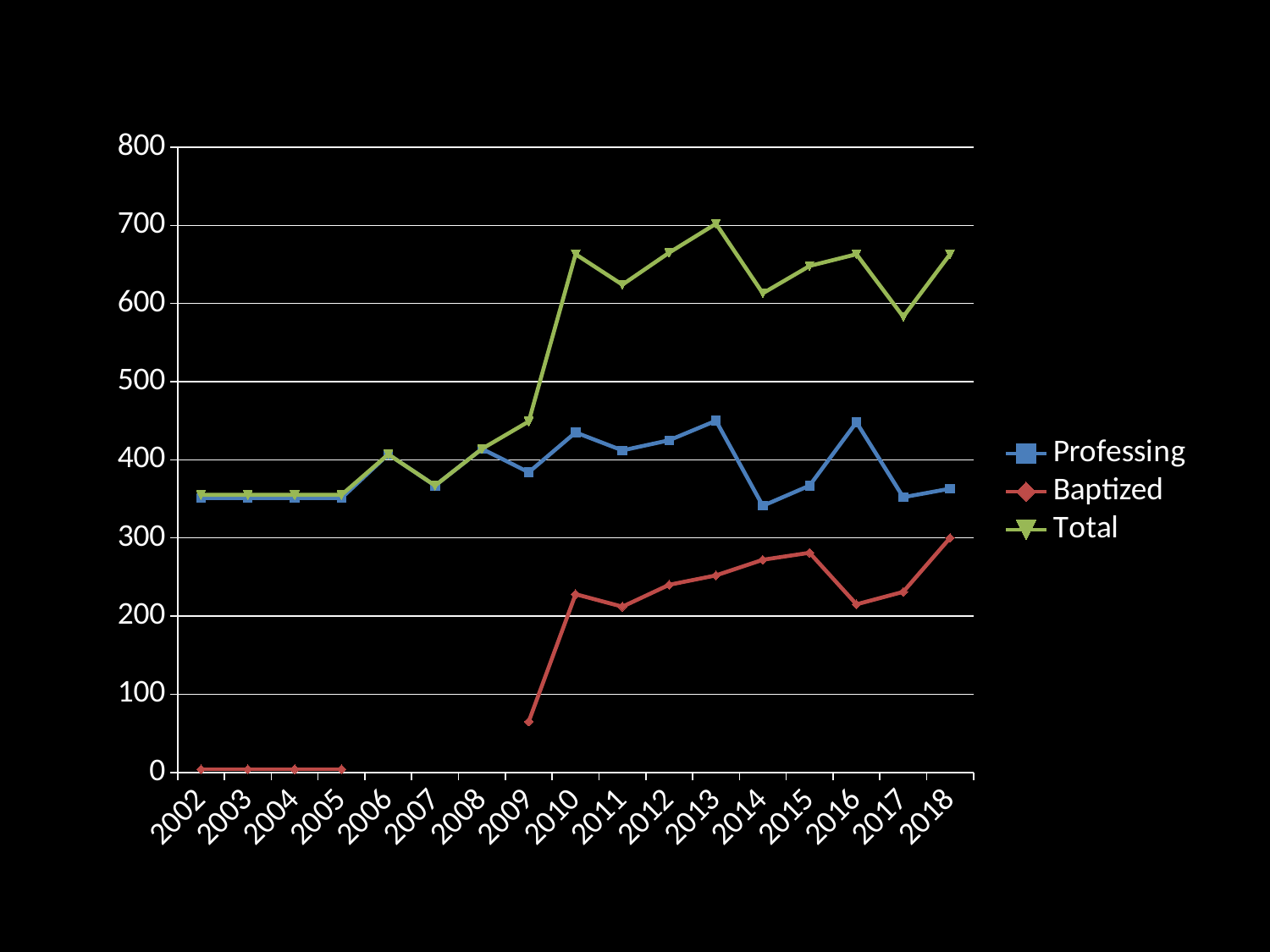
Is the Baptized value for 2009 greater or less than 100? less How many years are shown along the x axis? 17 Which is larger, the Professing value for 2016 or for 2017? 2016 In which year is the Total series at its highest? 2013 What colour is the line for the Total series? green Does the Baptized series rise or fall from 2010 to 2015? rise What kind of chart is shown on the slide? line chart How many series does the legend list? 3 Is the Professing value for 2013 greater or less than 400? greater Which is larger, the Total value for 2017 or for 2018? 2018 Is the Total value for 2010 greater or less than 600? greater In which year is the Baptized series at its highest? 2018